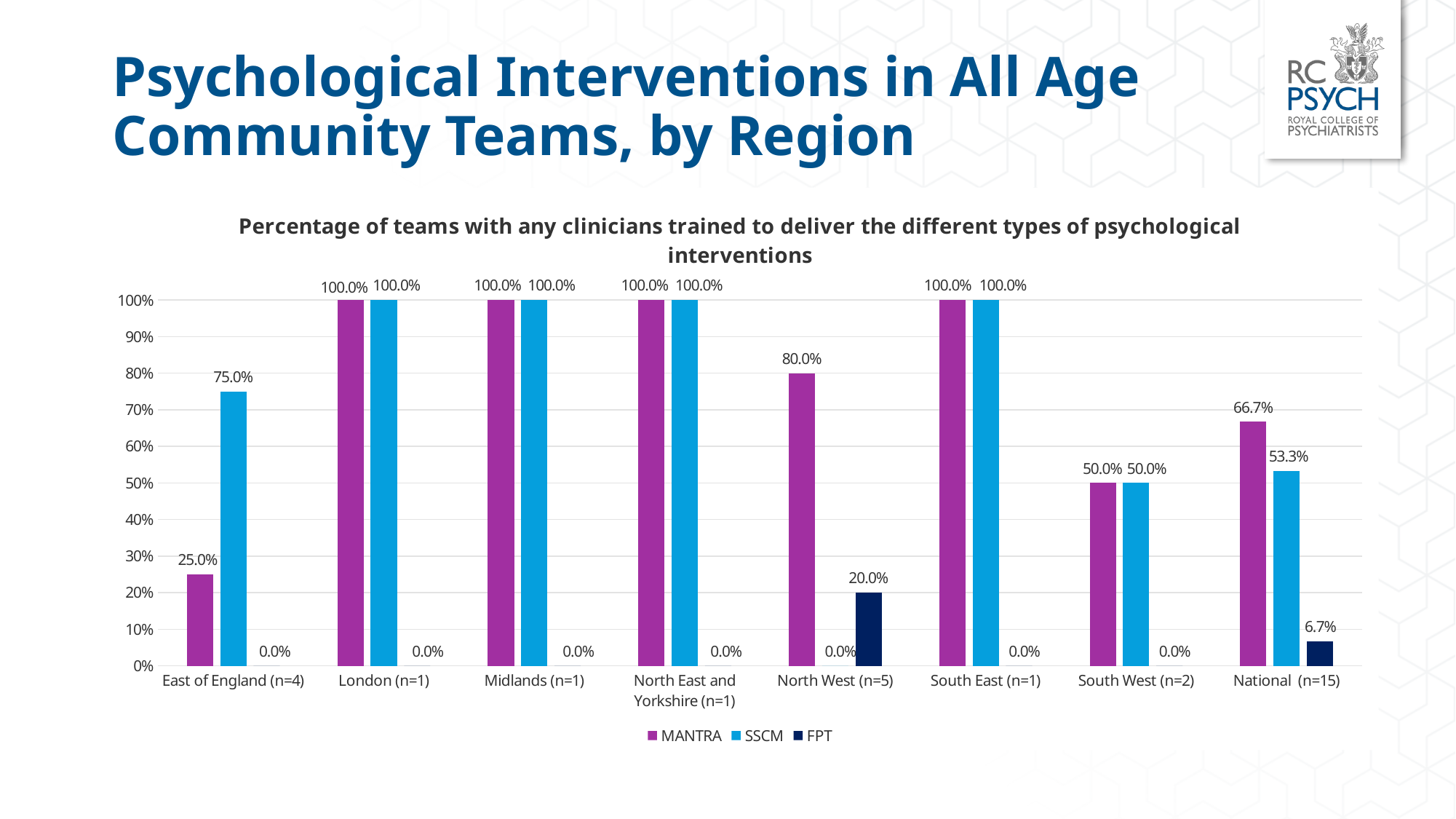
What is the SSCM value for National (n=15)? 53.3% For East of England (n=4), which is larger, the MANTRA value or the SSCM value? SSCM What is the MANTRA value for North West (n=5)? 80.0% What is the FPT value for National (n=15)? 6.7% How many series does the legend list? 3 Which region has the highest FPT value? North West (n=5) What kind of chart is shown on the slide? Bar chart What is the difference between the MANTRA and SSCM values for National (n=15)? 13.4% Which region has the lowest MANTRA value? East of England (n=4) What is the FPT value for North West (n=5)? 20.0% What is the MANTRA value for East of England (n=4)? 25.0% How many regions (categories) are shown on the x axis? 8